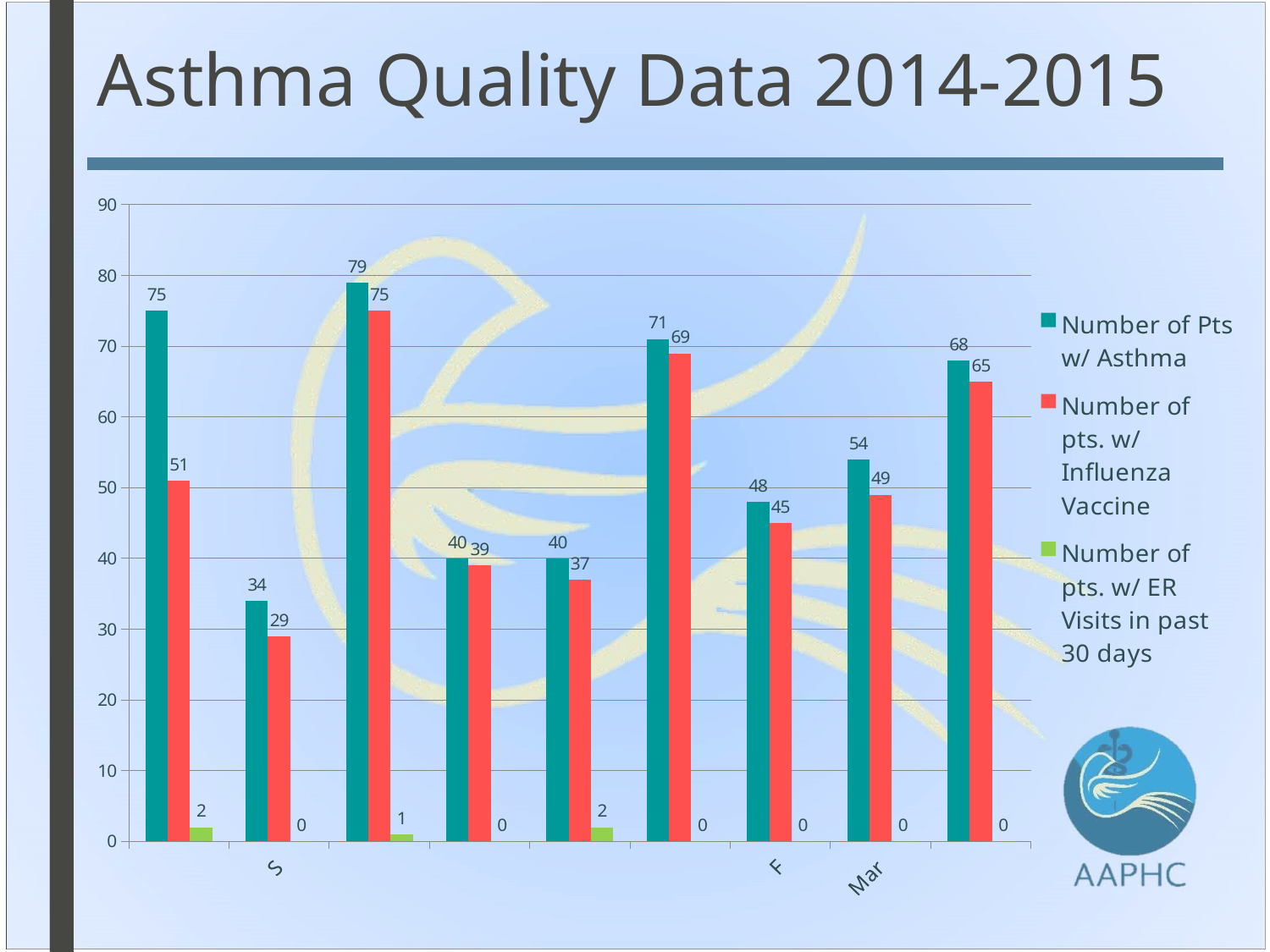
What is the Number of pts. w/ Influenza Vaccine for S? 29 What is the Number of Pts w/ Asthma for S? 34 What is the title of the chart? Asthma Quality Data 2014-2015 How many categories are plotted along the x axis? 9 What is the Number of Pts w/ Asthma for Mar? 54 What is the Number of pts. w/ Influenza Vaccine for F? 45 What is the highest value shown for Number of Pts w/ Asthma? 79 How many series does the legend list? 3 Which has the larger Number of Pts w/ Asthma, F or Mar? Mar What is the Number of pts. w/ ER Visits in past 30 days for Mar? 0 What kind of chart is shown on the slide? bar chart What is the difference between the Number of Pts w/ Asthma and the Number of pts. w/ Influenza Vaccine for Mar? 5